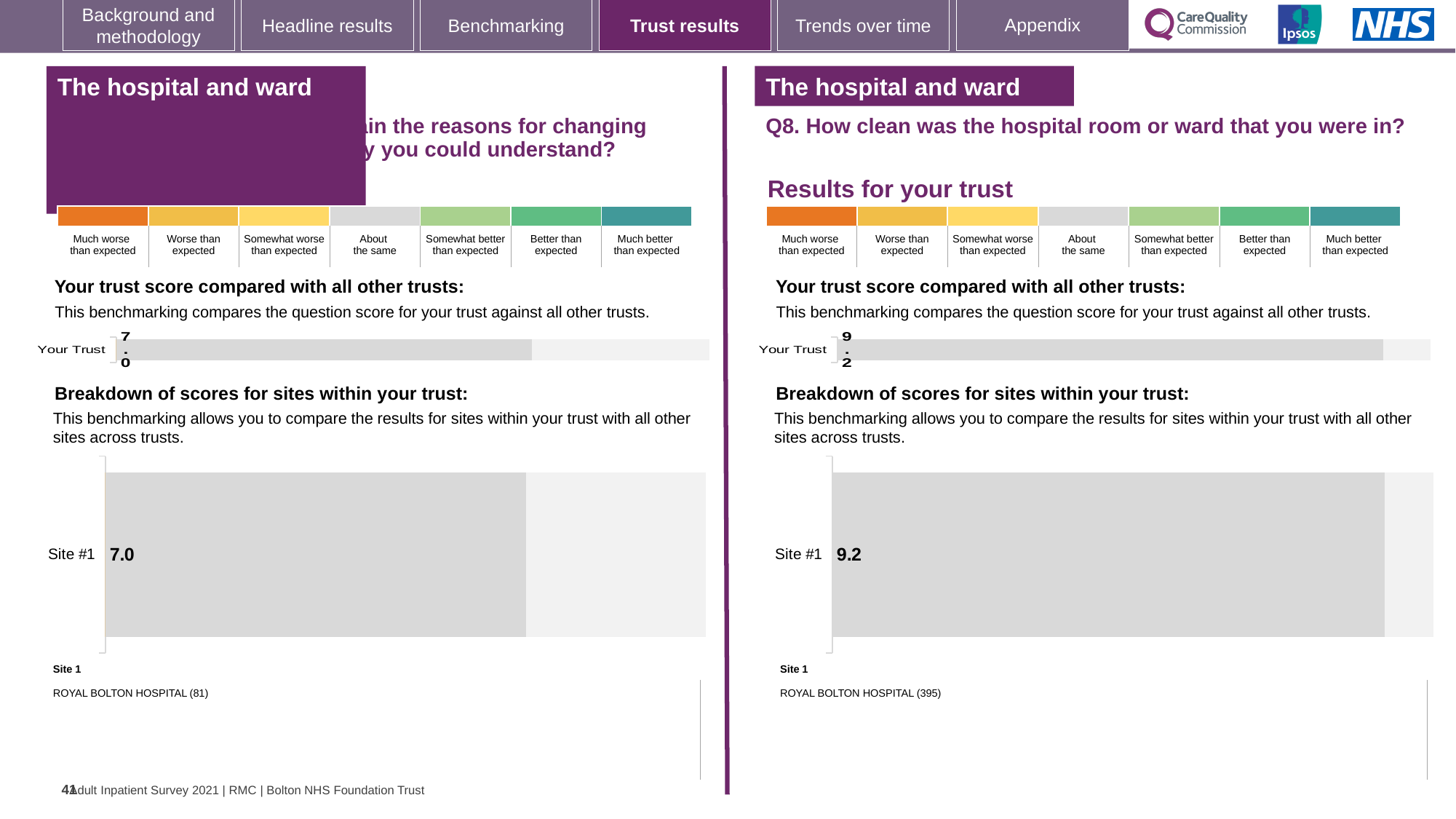
Which hospital is listed as Site 1 beneath the right-hand breakdown chart (Q8)? ROYAL BOLTON HOSPITAL (395) On the left-hand side of the slide, what is the score shown for Your Trust in the 'Your trust score compared with all other trusts' chart? 7.0 How many sites are shown in the left-hand 'Breakdown of scores for sites within your trust' chart? 1 Which hospital is listed as Site 1 beneath the left-hand breakdown chart? ROYAL BOLTON HOSPITAL (81) Which is larger: the Site #1 score in the left-hand breakdown chart or the Site #1 score in the right-hand breakdown chart (Q8)? The right-hand (Q8) Site #1 score On the right-hand side of the slide (Q8, how clean was the hospital room or ward), what is the score shown for Your Trust? 9.2 In the right-hand 'Breakdown of scores for sites within your trust' chart (Q8), what is the score for Site #1? 9.2 What type of chart is used in the right-hand 'Breakdown of scores for sites within your trust' section (Q8)? Bar chart What is the difference between the Site #1 score in the right-hand breakdown chart (Q8) and the Site #1 score in the left-hand breakdown chart? 2.2 In the left-hand 'Breakdown of scores for sites within your trust' chart, what is the score for Site #1? 7.0 How many sites are shown in the right-hand 'Breakdown of scores for sites within your trust' chart (Q8)? 1 What type of chart is used to show 'Your Trust' score on the left-hand side of the slide? Bar chart